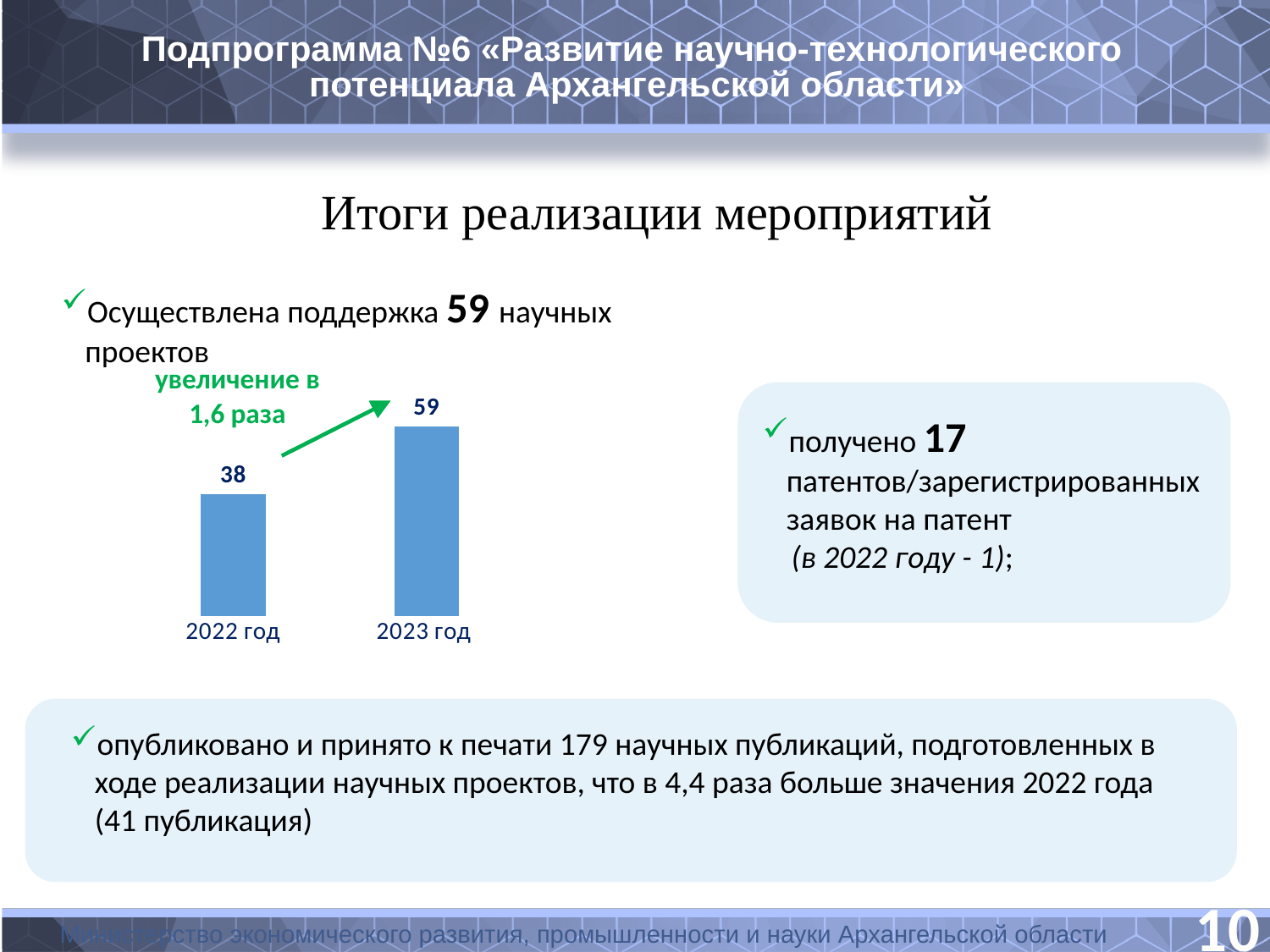
How many categories are shown in the bar chart? 2 What colour are the bars in the chart? blue What is the value for 2022 год in the bar chart? 38 Which year has the higher value in the bar chart? 2023 год What increase factor is written in green next to the arrow above the bar chart? увеличение в 1,6 раза Do the values in the bar chart rise or fall from 2022 год to 2023 год? rise Is the value for 2023 год larger or smaller than the value for 2022 год? larger What is the value for 2023 год in the bar chart? 59 What is the difference between the 2023 год and 2022 год values in the bar chart? 21 Which year has the lower value in the bar chart? 2022 год What kind of chart is shown on the slide? bar chart